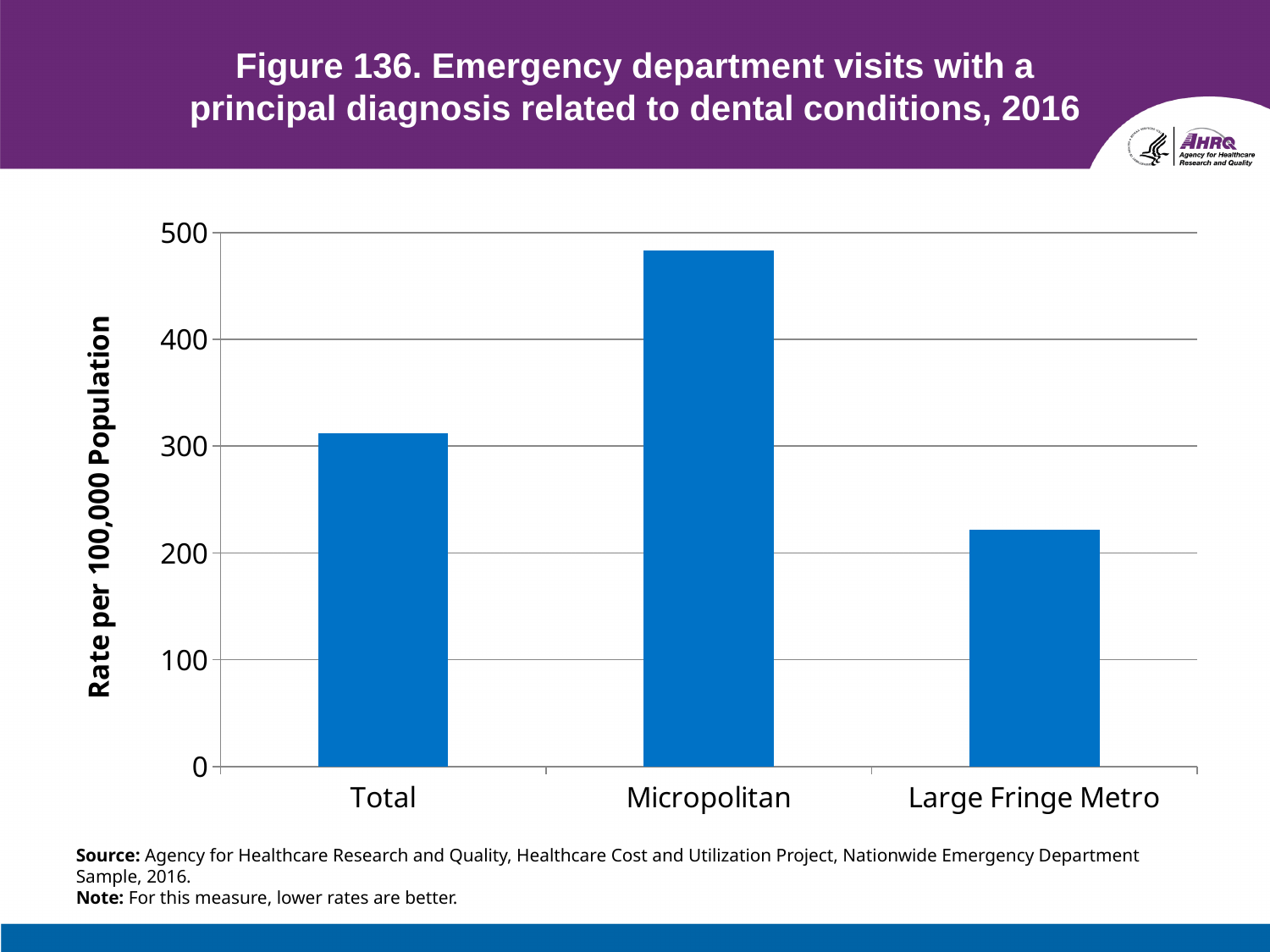
Is the value for Micropolitan greater or less than 500? less Which category has the lowest rate of emergency department visits? Large Fringe Metro How many categories are shown on the x axis? 3 Is the value for Micropolitan greater or less than 400? greater Which category has the highest rate of emergency department visits? Micropolitan Which is larger, the value for Micropolitan or the value for Total? Micropolitan What is the label of the y axis? Rate per 100,000 Population Is the value for Total greater or less than 300? greater Which is larger, the value for Total or the value for Large Fringe Metro? Total What kind of chart is shown on the slide? bar chart What year does the chart title say the data are from? 2016